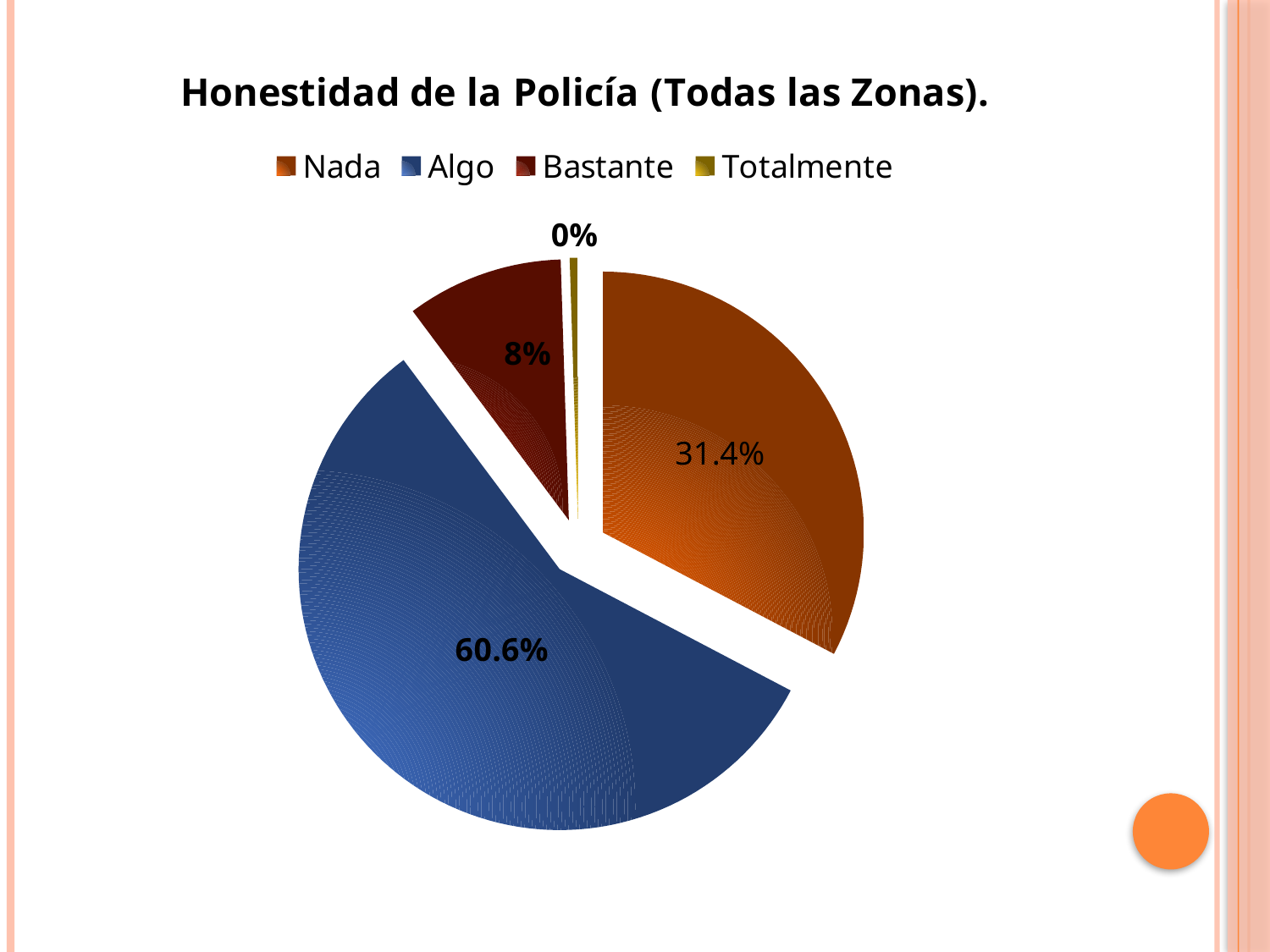
What percentage is shown for Totalmente? 0% Which legend entry is shown in blue? Algo What percentage is shown for Algo? 60.6% Which is larger, the slice for Nada or the slice for Bastante? Nada What is the difference between the percentages for Algo and Nada? 29.2% Which category has the smallest slice? Totalmente What percentage is shown for Bastante? 8% How many categories does the legend list? 4 Which category has the largest slice? Algo What kind of chart is shown on the slide? pie chart What percentage is shown for Nada? 31.4% What is the title of the chart? Honestidad de la Policía (Todas las Zonas).